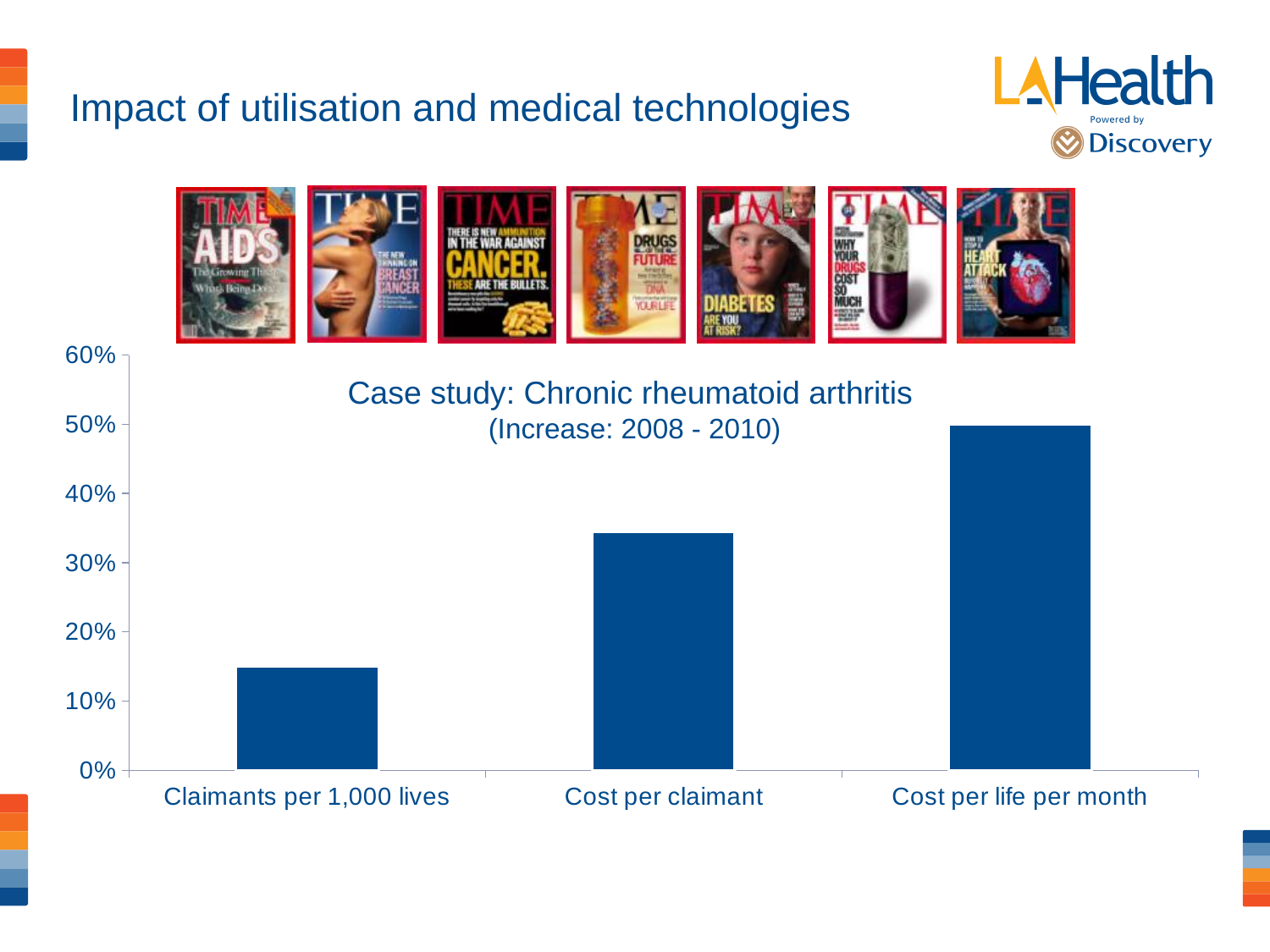
Is the value for Cost per claimant greater or less than 30%? greater Is the value for Cost per claimant greater or less than 40%? less What is the title of the chart? Case study: Chronic rheumatoid arthritis (Increase: 2008 - 2010) How many categories are shown on the x axis of the chart? 3 Which is larger, the value for Cost per claimant or the value for Claimants per 1,000 lives? Cost per claimant Which category has the highest bar in the chart? Cost per life per month Do the bar values rise or fall from left to right across the x axis? Rise Is the value for Claimants per 1,000 lives greater or less than 10%? greater What kind of chart is shown on the slide? Bar chart Which category has the lowest bar in the chart? Claimants per 1,000 lives